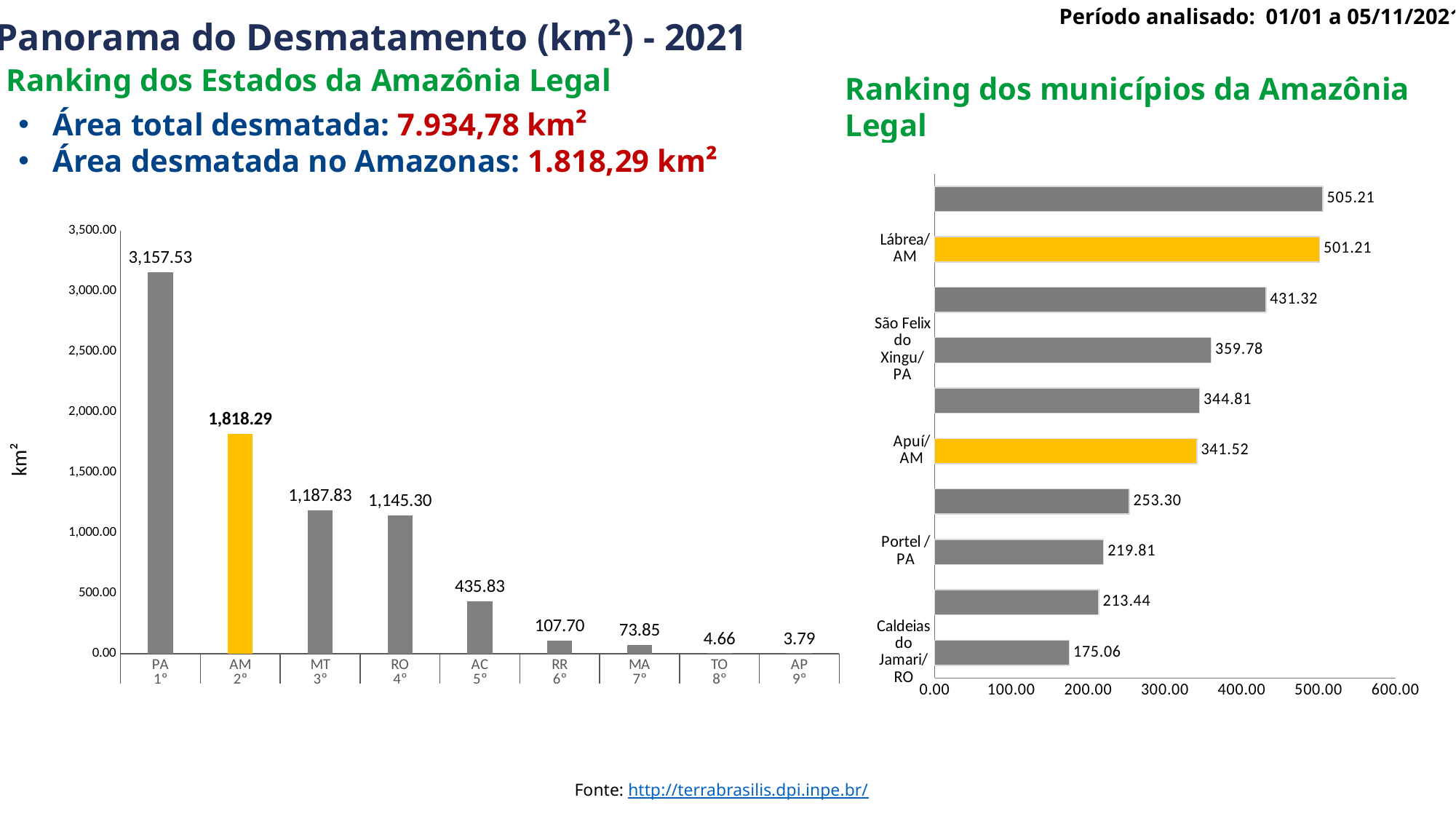
In the 'Ranking dos municípios da Amazônia Legal' chart, what is the value for Lábrea/AM? 501.21 What kind of chart is the 'Ranking dos municípios da Amazônia Legal' chart? bar chart In the 'Ranking dos municípios da Amazônia Legal' chart, which bars are highlighted in yellow? Lábrea/AM and Apuí/AM In the 'Ranking dos municípios da Amazônia Legal' chart, what is the value for Portel / PA? 219.81 In the 'Ranking dos Estados da Amazônia Legal' chart, what is the difference between the values for PA and AM? 1,339.24 In the 'Ranking dos Estados da Amazônia Legal' chart, which is larger, the value for MT or the value for RO? MT In the 'Ranking dos Estados da Amazônia Legal' chart, what is the value for AC? 435.83 In the 'Ranking dos Estados da Amazônia Legal' chart, what is the value for PA? 3,157.53 In the 'Ranking dos Estados da Amazônia Legal' chart, how many states are shown? 9 In the 'Ranking dos Estados da Amazônia Legal' chart, which state has the lowest value? AP In the 'Ranking dos municípios da Amazônia Legal' chart, what is the difference between the values for São Felix do Xingu/PA and Apuí/AM? 18.26 In the 'Ranking dos Estados da Amazônia Legal' chart, do the values rise or fall from left to right? fall